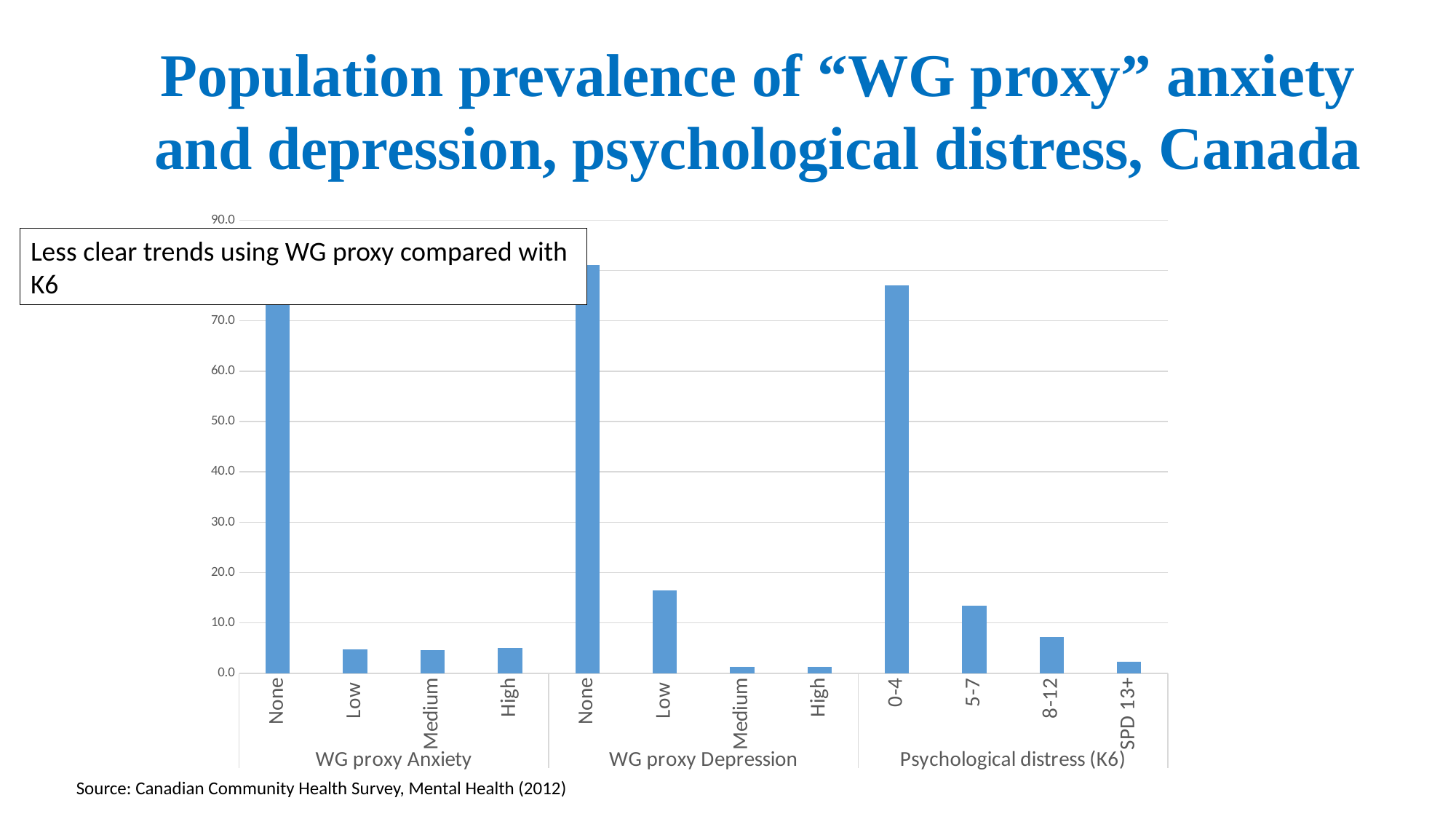
How many groups of categories are shown along the x axis of the chart? 3 Is the value for Low under WG proxy Depression greater or less than 10.0? greater How many bars are plotted in the chart in total? 12 Is the value for 0-4 under Psychological distress (K6) greater or less than 70.0? greater Which is larger: the value for Medium under WG proxy Anxiety or the value for Medium under WG proxy Depression? Medium under WG proxy Anxiety What is the highest tick value shown on the y axis of the chart? 90.0 Within the Psychological distress (K6) group, which category has the lowest value? SPD 13+ Within the Psychological distress (K6) group, do the values rise or fall from 0-4 to SPD 13+? fall What does the text box overlaid on the chart say? Less clear trends using WG proxy compared with K6 What kind of chart is shown on the slide? Bar chart Is the value for 8-12 under Psychological distress (K6) greater or less than 10.0? less